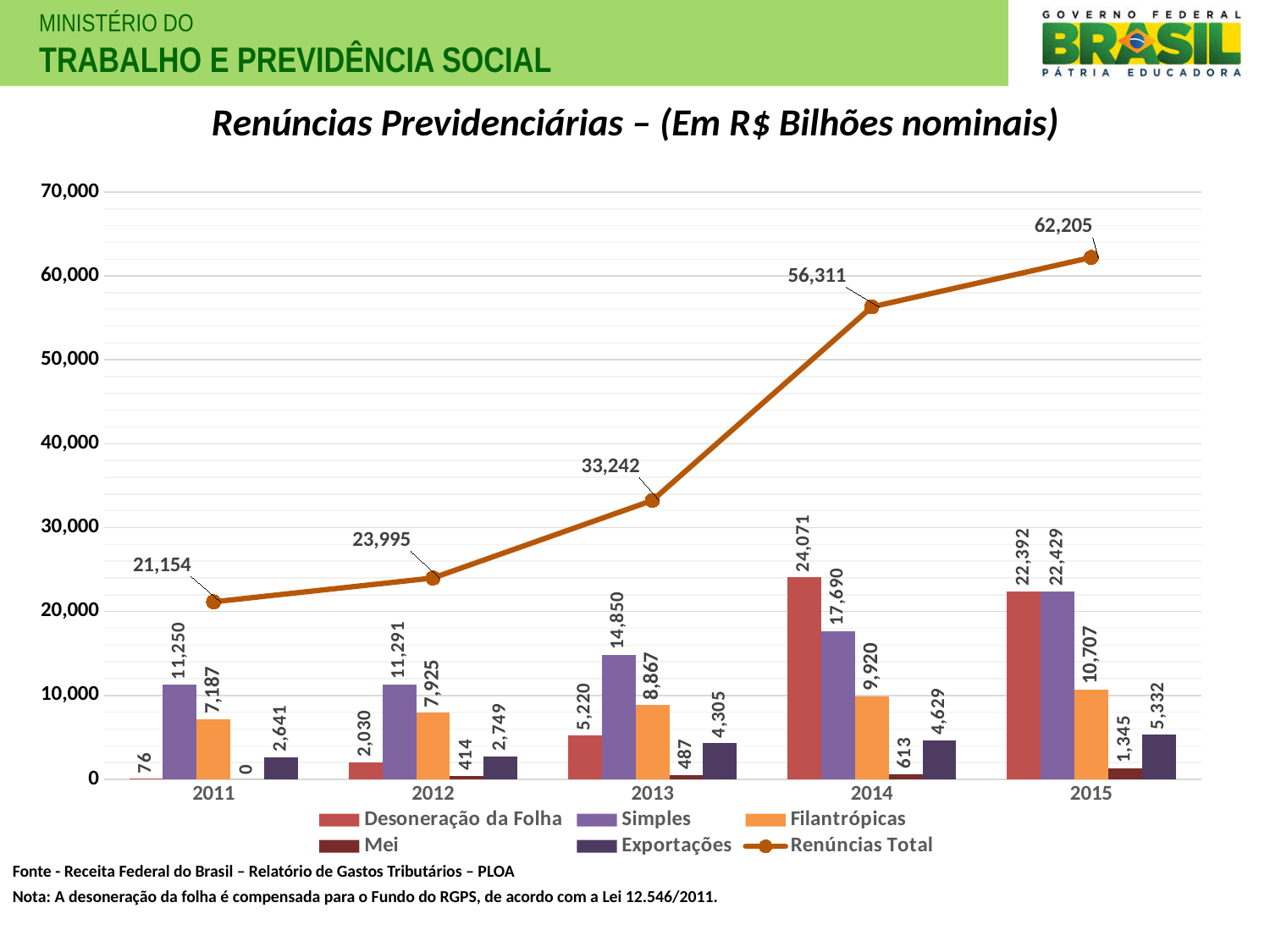
Which is larger in 2015, Desoneração da Folha or Simples? Simples What is the value of Simples in 2013? 14,850 What is the value of Mei in 2011? 0 Is the value of Filantrópicas in 2015 greater or less than 10,000? greater What is the difference between Renúncias Total in 2014 and in 2013? 23,069 In which year is Exportações the lowest? 2011 Does Renúncias Total rise or fall from 2011 to 2015? rise How many series does the legend list? 6 In which year is Renúncias Total the highest? 2015 What is the value of Renúncias Total for 2015? 62,205 What is the value of Desoneração da Folha in 2014? 24,071 How many years are shown on the x axis? 5